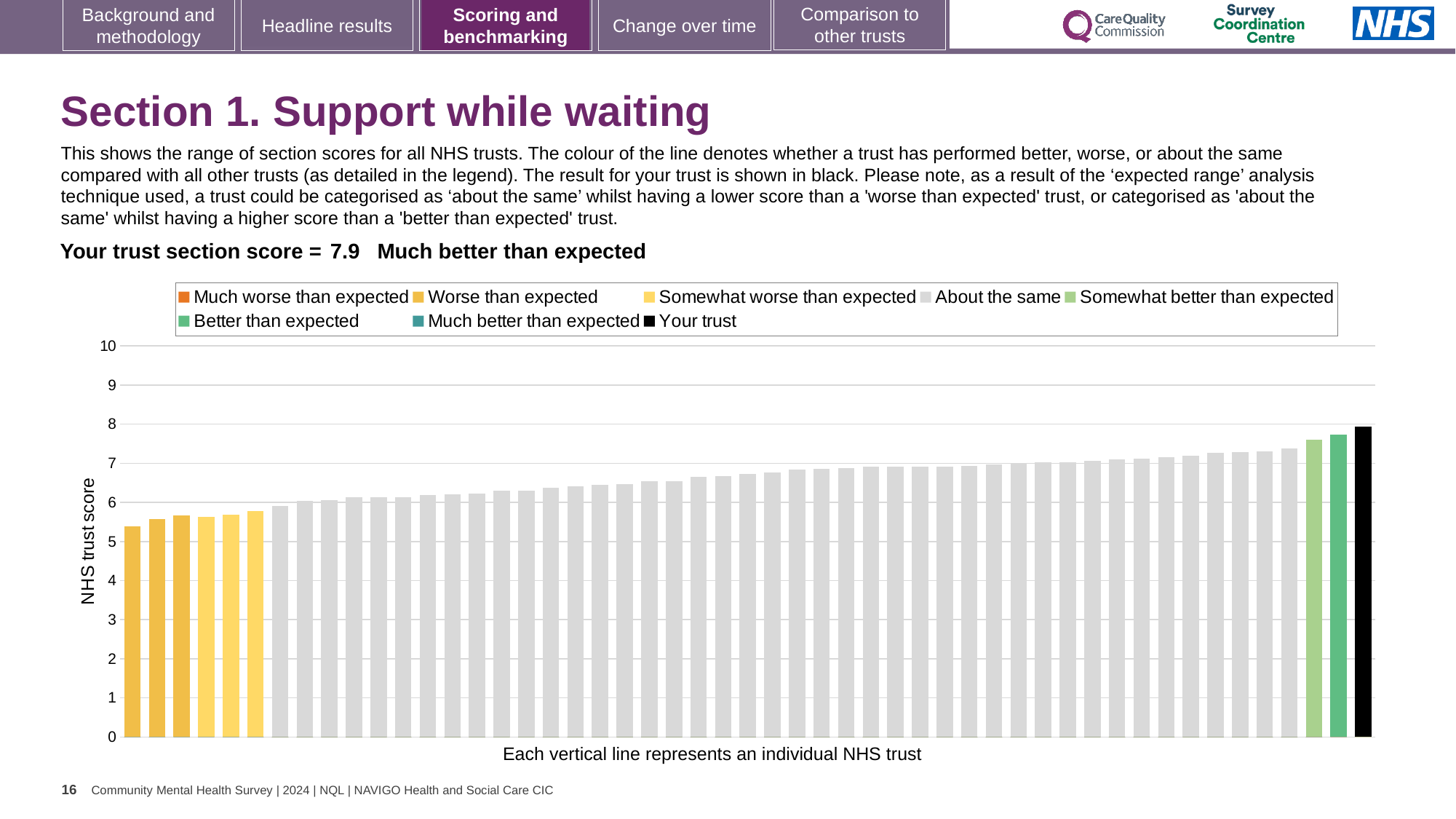
Is the value of the Your trust bar greater or less than 8? less What is the section score for your trust shown on the slide? 7.9 Is the value of the Your trust bar greater or less than 7? greater Do the bar values rise or fall from left to right along the x axis? rise Which bar in the chart is the highest? Your trust Is the value of the leftmost (lowest) bar greater or less than 6? less How many entries does the chart legend list? 8 What is the label on the y axis of the chart? NHS trust score What colour is the bar representing Your trust? black What is the highest value shown on the y axis? 10 What kind of chart is shown on the slide? bar chart